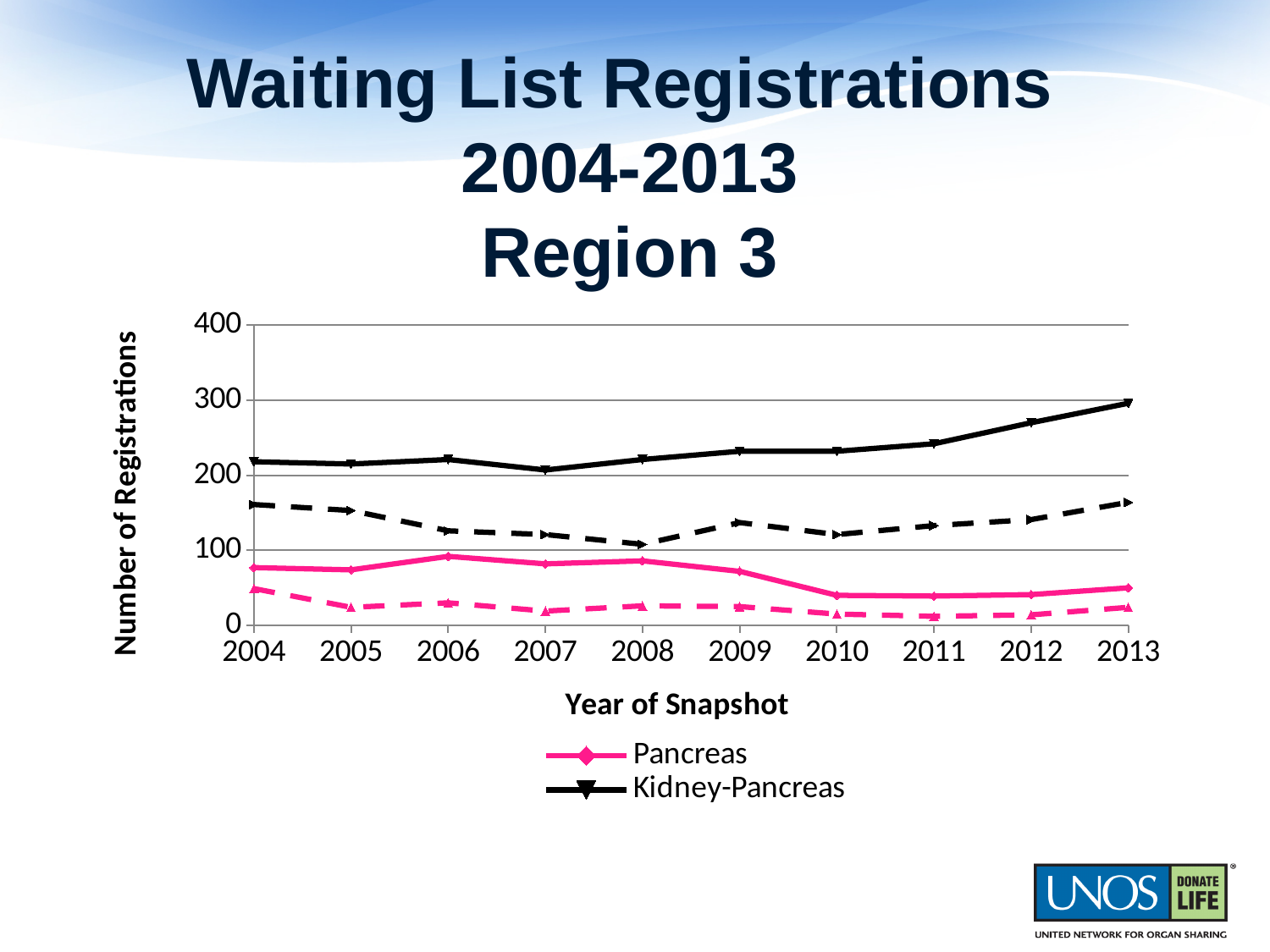
How many years are plotted along the x axis? 10 How many series does the legend list? 2 Is the Kidney-Pancreas solid-line value for 2004 greater or less than 300? less Does the Kidney-Pancreas solid line rise or fall from 2010 to 2013? rise In 2013, which series has the higher solid-line value, Pancreas or Kidney-Pancreas? Kidney-Pancreas What is the title of the y axis? Number of Registrations Is the Kidney-Pancreas solid-line value for 2013 greater or less than 200? greater Is the Pancreas solid-line value for 2010 greater or less than 100? less In which year is the Kidney-Pancreas solid line at its highest? 2013 What kind of chart is shown on the slide? line chart Does the Pancreas solid line rise or fall from 2006 to 2010? fall In which year is the Pancreas solid line at its highest? 2006